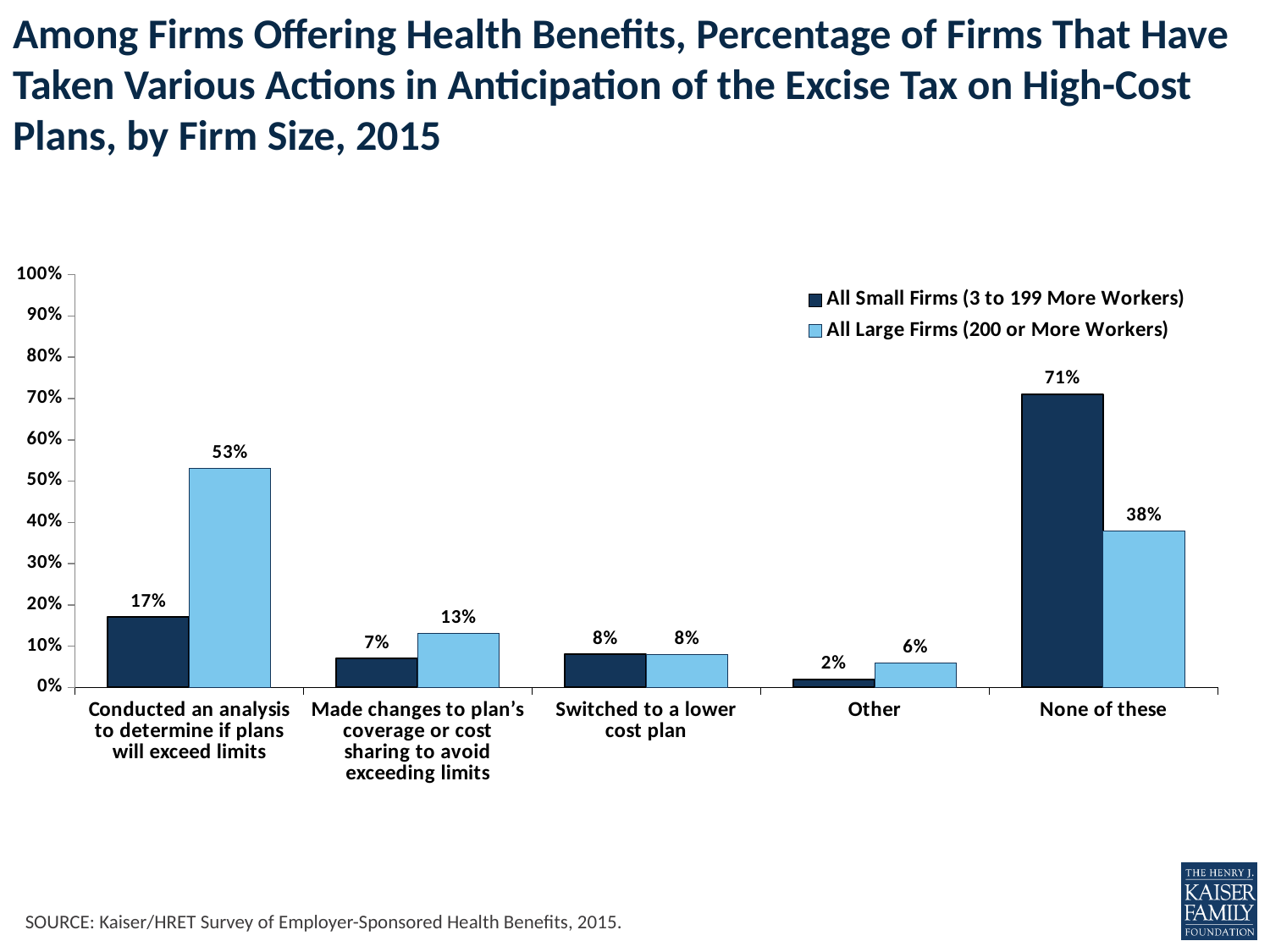
What percentage of all large firms (200 or more workers) conducted an analysis to determine if plans will exceed limits? 53% What percentage of all large firms made changes to plan's coverage or cost sharing to avoid exceeding limits? 13% What kind of chart is shown on the slide? Bar chart What percentage of all small firms reported 'Other' actions? 2% Which category has the highest value for all small firms? None of these Which category has the lowest value for all large firms? Other How many series does the legend list? 2 What is the difference between small firms and large firms for 'None of these'? 33 percentage points Which is larger for 'Conducted an analysis to determine if plans will exceed limits': small firms or large firms? Large firms What percentage of all small firms (3 to 199 workers) conducted an analysis to determine if plans will exceed limits? 17% What is the source cited at the bottom of the slide? Kaiser/HRET Survey of Employer-Sponsored Health Benefits, 2015 How many action categories are shown on the x axis? 5